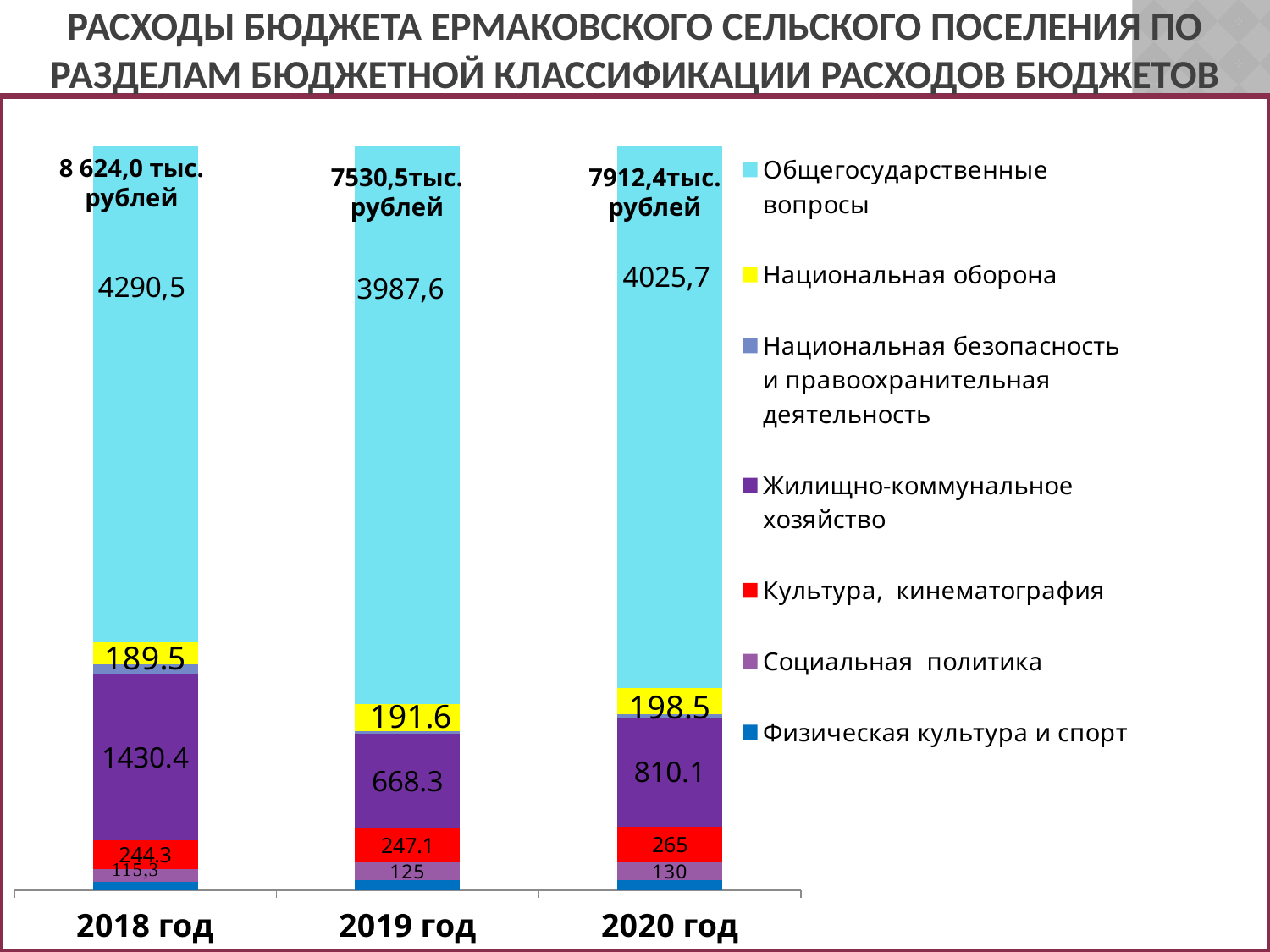
How many series does the legend list? 7 What is the value for Культура, кинематография in 2020 год? 265 Which year has the highest value for Жилищно-коммунальное хозяйство? 2018 год How many years (bars) are shown on the x axis? 3 What is the value for Жилищно-коммунальное хозяйство in 2019 год? 668.3 What is the total printed above the bar for 2018 год? 8 624,0 тыс. рублей Which is larger: Культура, кинематография in 2019 год or in 2020 год? 2020 год What is the value for Социальная политика in 2019 год? 125 What is the value for Национальная оборона in 2020 год? 198.5 What is the value for Общегосударственные вопросы in 2018 год? 4290,5 Which year has the lowest total budget expenditure? 2019 год What kind of chart is shown on the slide? stacked bar chart